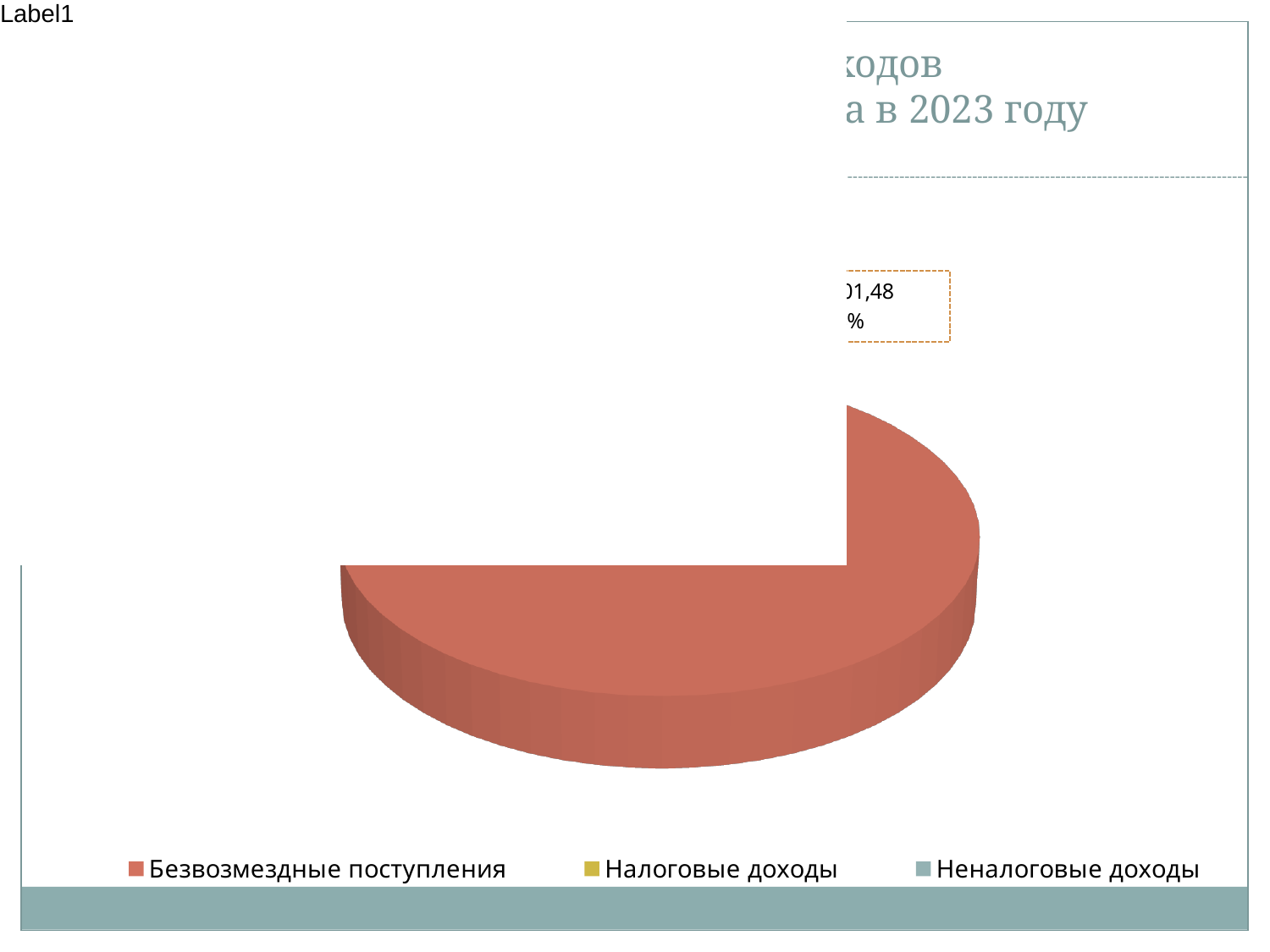
Which category has the largest slice in the pie chart? Безвозмездные поступления What kind of chart is shown on the slide? pie chart How many categories does the legend of the pie chart list? 3 Which legend entry is shown in red in the pie chart? Безвозмездные поступления Which year is mentioned in the chart title? 2023